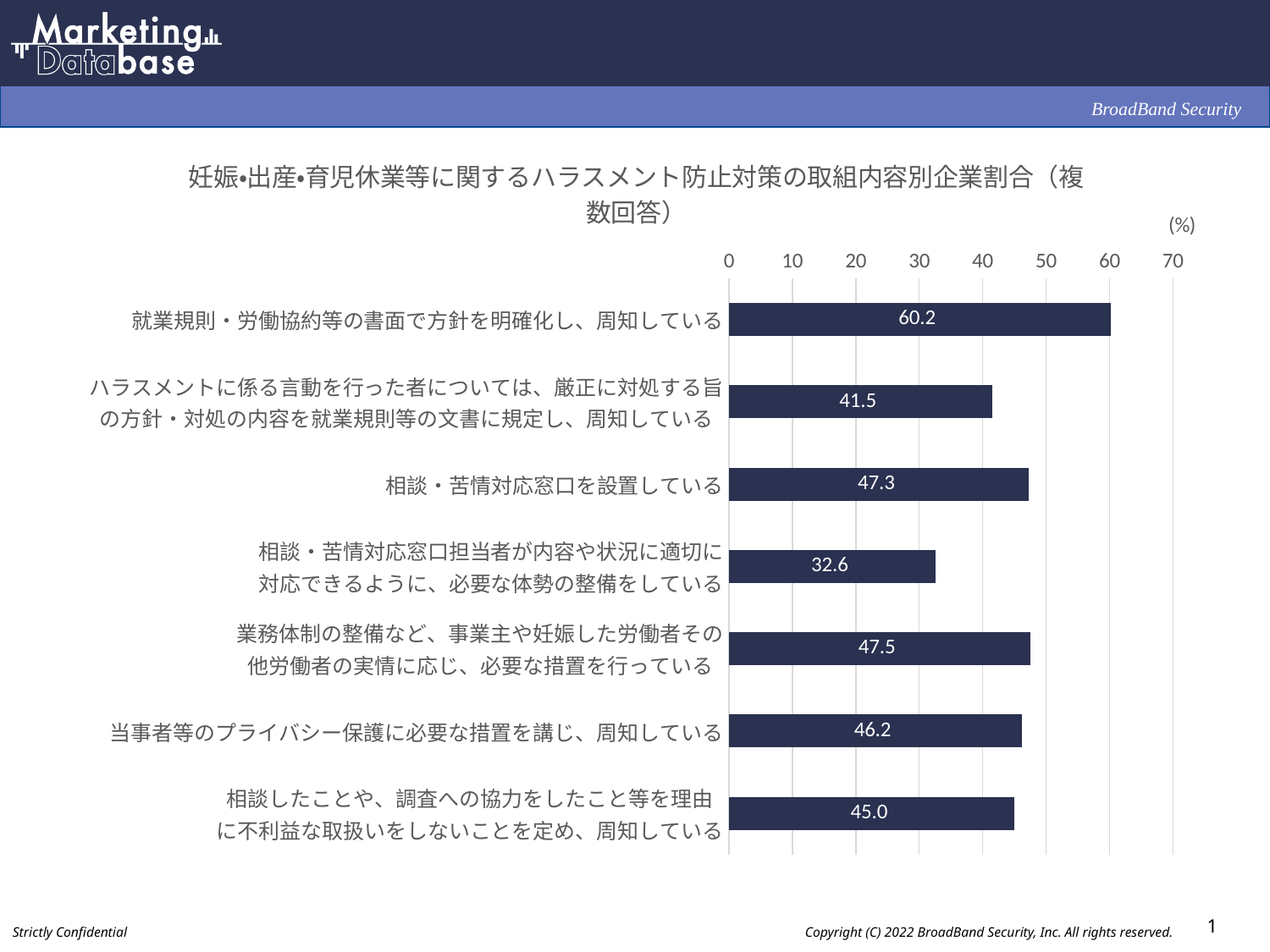
What is the value for 相談したことや、調査への協力をしたこと等を理由に不利益な取扱いをしないことを定め、周知している? 45.0 Is the value for 業務体制の整備など、事業主や妊娠した労働者その他労働者の実情に応じ、必要な措置を行っている greater or less than 50? less What is the difference between the highest value (60.2) and the lowest value (32.6)? 27.6 What is the value for 就業規則・労働協約等の書面で方針を明確化し、周知している? 60.2 Which category has the lowest value? 相談・苦情対応窓口担当者が内容や状況に適切に対応できるように、必要な体勢の整備をしている Which category has the highest value? 就業規則・労働協約等の書面で方針を明確化し、周知している What unit is shown above the axis of the chart? (%) What kind of chart is shown on the slide? bar chart Which is larger: the value for 相談・苦情対応窓口を設置している or the value for ハラスメントに係る言動を行った者については、厳正に対処する旨の方針・対処の内容を就業規則等の文書に規定し、周知している? 相談・苦情対応窓口を設置している What is the value for 相談・苦情対応窓口を設置している? 47.3 What is the value for 当事者等のプライバシー保護に必要な措置を講じ、周知している? 46.2 How many categories are plotted in the chart? 7